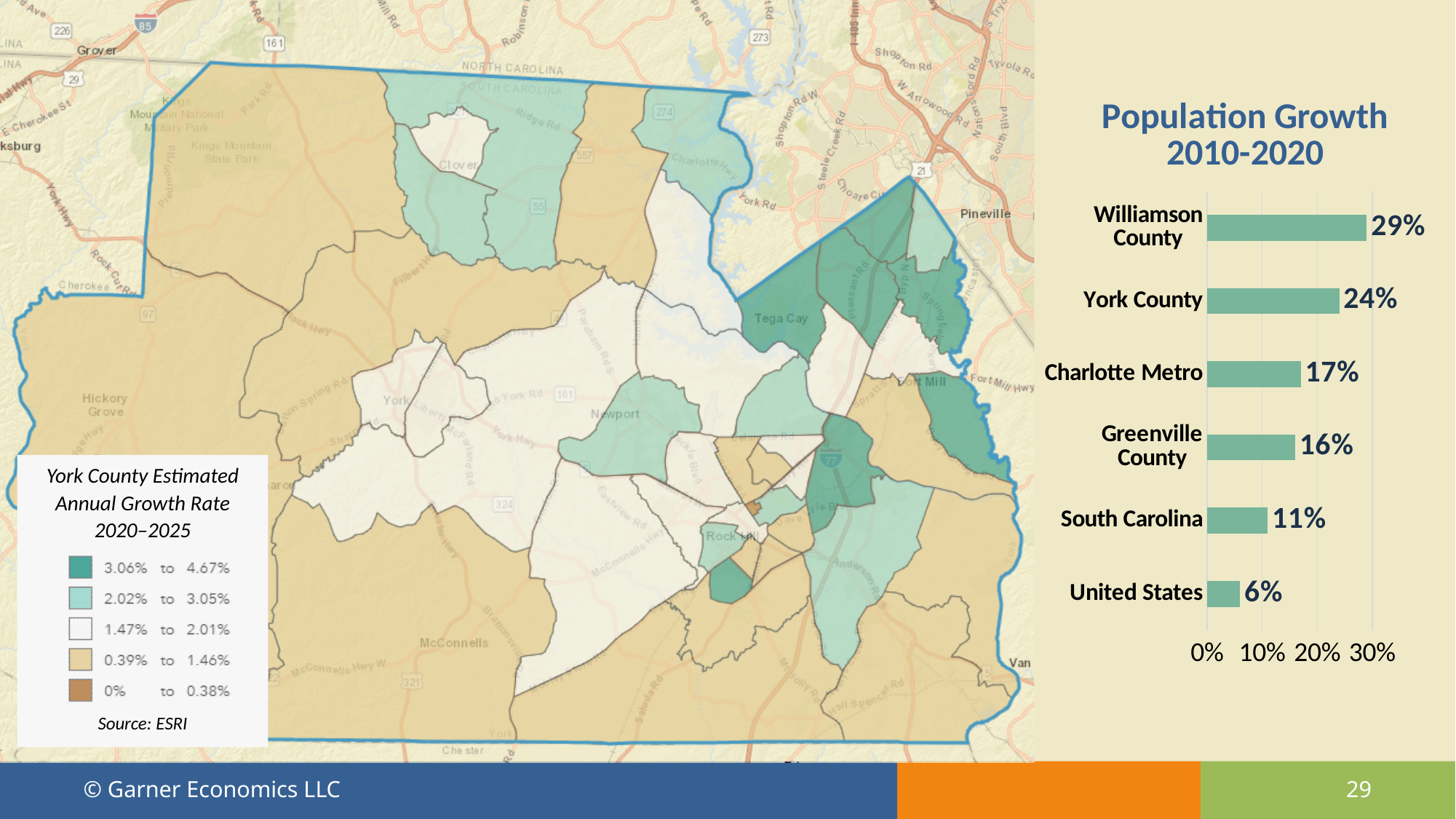
In the Population Growth 2010-2020 chart, what is the difference between Williamson County and York County? 5% In the Population Growth 2010-2020 chart, which category has the lowest value? United States What is the title of the chart on the right side of the slide? Population Growth 2010-2020 In the Population Growth 2010-2020 chart, what is the value for York County? 24% In the Population Growth 2010-2020 chart, which is larger, Charlotte Metro or Greenville County? Charlotte Metro How many categories are shown in the Population Growth 2010-2020 chart? 6 In the Population Growth 2010-2020 chart, is the value for South Carolina greater or less than 20%? less In the Population Growth 2010-2020 chart, what is the difference between South Carolina and the United States? 5% In the Population Growth 2010-2020 chart, which category has the highest value? Williamson County What kind of chart is the Population Growth 2010-2020 chart? bar chart In the Population Growth 2010-2020 chart, what is the value for Charlotte Metro? 17% In the Population Growth 2010-2020 chart, what is the value for the United States? 6%